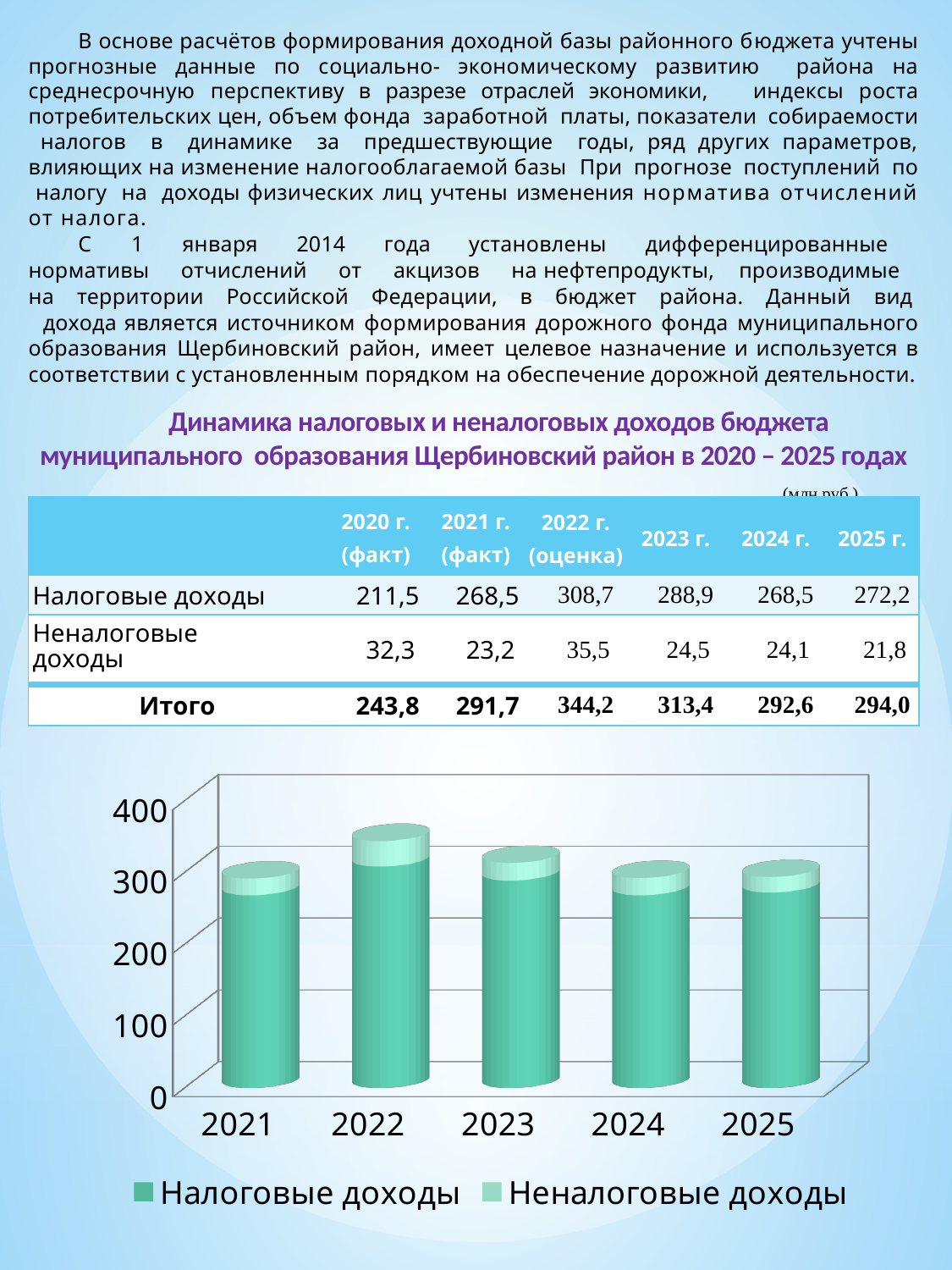
Is the total stacked bar for 2024 greater or less than 200? greater Do the stacked bar totals rise or fall from 2022 to 2025? fall Which stacked bar is taller in the chart, 2022 or 2024? 2022 According to the table above the chart, what is the total (Итого) for 2022? 344,2 Is the total stacked bar for 2022 greater or less than 400? less According to the table above the chart, what is the value of Неналоговые доходы for 2025? 21,8 How many years are shown on the x axis of the chart? 5 How many series does the chart legend list? 2 Which year has the tallest stacked bar in the chart? 2022 What type of chart is shown at the bottom of the slide? bar chart Is the total stacked bar for 2022 greater or less than 300? greater What are the two series named in the chart legend? Налоговые доходы, Неналоговые доходы